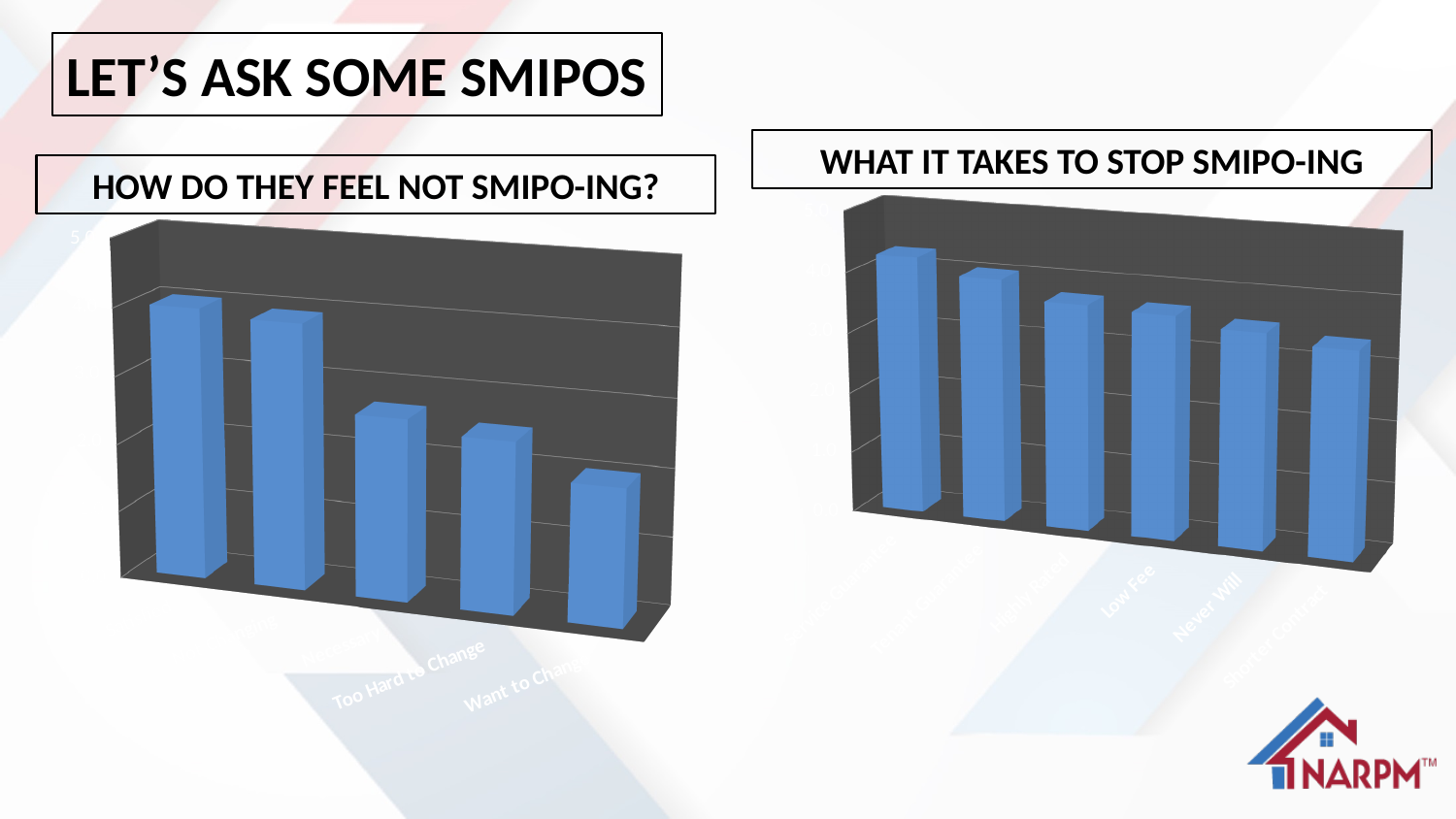
How many bars are plotted in the left chart, "HOW DO THEY FEEL NOT SMIPO-ING?"? 5 What is the title of the chart on the right side of the slide? WHAT IT TAKES TO STOP SMIPO-ING In the right chart, "WHAT IT TAKES TO STOP SMIPO-ING", which category has the lowest bar? Shorter Contract In the left chart, "HOW DO THEY FEEL NOT SMIPO-ING?", do the bar values rise or fall from left to right? Fall In the right chart, "WHAT IT TAKES TO STOP SMIPO-ING", which is larger: Low Fee or Shorter Contract? Low Fee What kind of chart is the left chart titled "HOW DO THEY FEEL NOT SMIPO-ING?"? Bar chart In the right chart, "WHAT IT TAKES TO STOP SMIPO-ING", do the bar values rise or fall from left to right? Fall In the left chart, "HOW DO THEY FEEL NOT SMIPO-ING?", which is larger: Too Hard to Change or Want to Change? Too Hard to Change In the right chart, "WHAT IT TAKES TO STOP SMIPO-ING", which is larger: Never Will or Shorter Contract? Never Will What kind of chart is the right chart titled "WHAT IT TAKES TO STOP SMIPO-ING"? Bar chart In the left chart, "HOW DO THEY FEEL NOT SMIPO-ING?", which category has the lowest bar? Want to Change How many bars are plotted in the right chart, "WHAT IT TAKES TO STOP SMIPO-ING"? 6